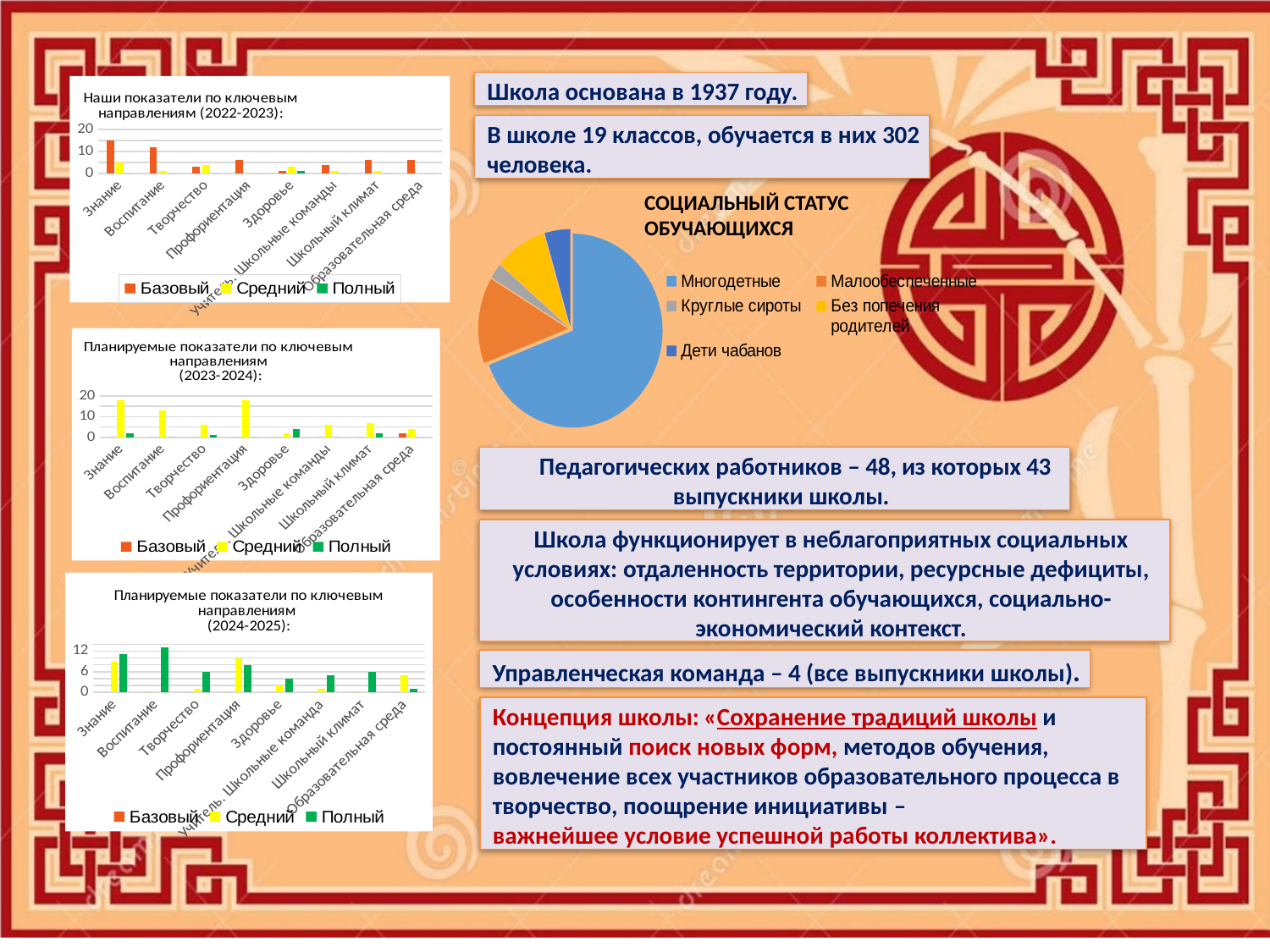
How many categories are shown on the x axis of the "Планируемые показатели по ключевым направлениям (2023-2024)" chart? 8 How many series does the legend of the "Наши показатели по ключевым направлениям (2022-2023)" chart list? 3 What are the legend entries of the "Планируемые показатели по ключевым направлениям (2024-2025)" chart? Базовый, Средний, Полный What kind of chart is "Наши показатели по ключевым направлениям (2022-2023)"? bar chart In the "СОЦИАЛЬНЫЙ СТАТУС ОБУЧАЮЩИХСЯ" pie chart, which category has the largest slice? Многодетные In the "Наши показатели по ключевым направлениям (2022-2023)" chart, which series has the larger value for Знание: Базовый or Средний? Базовый In the "Наши показатели по ключевым направлениям (2022-2023)" chart, is the Базовый value for Знание greater or less than 10? greater In the "Планируемые показатели по ключевым направлениям (2024-2025)" chart, which category has the larger Полный value: Воспитание or Творчество? Воспитание In the "Планируемые показатели по ключевым направлениям (2024-2025)" chart, is the Полный value for Воспитание greater or less than 6? greater How many categories does the legend of the "СОЦИАЛЬНЫЙ СТАТУС ОБУЧАЮЩИХСЯ" chart list? 5 What kind of chart is "СОЦИАЛЬНЫЙ СТАТУС ОБУЧАЮЩИХСЯ"? pie chart In the "Планируемые показатели по ключевым направлениям (2023-2024)" chart, is the Средний value for Знание greater or less than 10? greater